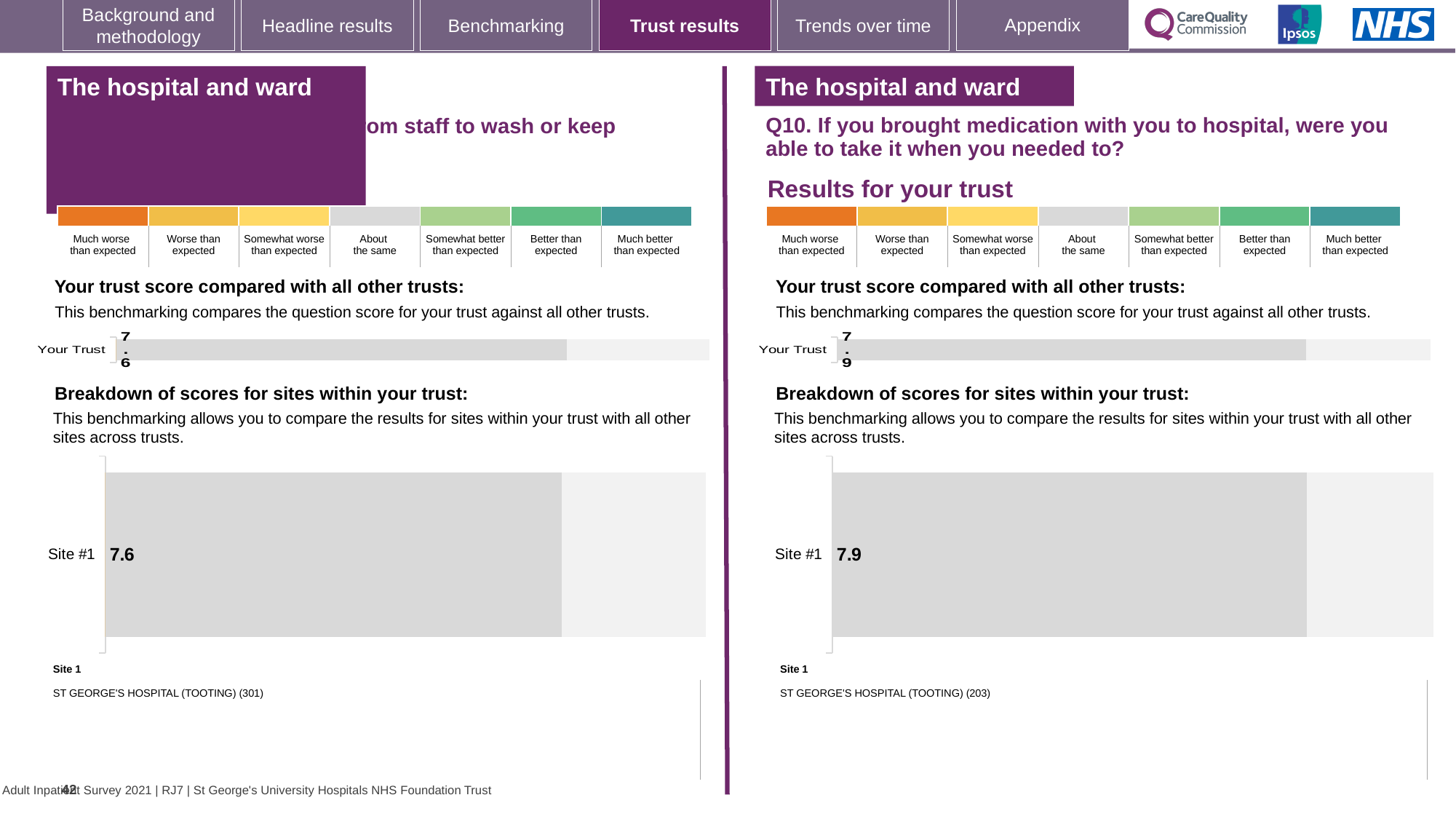
In the left-hand breakdown chart, which site name is listed as Site 1? ST GEORGE'S HOSPITAL (TOOTING) (301) In the right-hand breakdown chart (Q10), which site name is listed as Site 1? ST GEORGE'S HOSPITAL (TOOTING) (203) On the left-hand side of the slide, what is the score shown for Your Trust? 7.6 How many sites are shown in the right-hand 'Breakdown of scores for sites within your trust' chart (Q10)? 1 What kind of chart is used for the 'Breakdown of scores for sites within your trust' on the right-hand side (Q10)? Bar chart What is the difference between the Site #1 score in the right-hand breakdown chart (Q10) and the Site #1 score in the left-hand breakdown chart? 0.3 How many sites are shown in the left-hand 'Breakdown of scores for sites within your trust' chart? 1 In the left-hand 'Breakdown of scores for sites within your trust' chart, what is the score for Site #1? 7.6 Is the Your Trust score on the right-hand side of the slide (Q10) greater or less than the Your Trust score on the left-hand side? greater On the right-hand side of the slide (Q10, medication), what is the score shown for Your Trust? 7.9 In the right-hand 'Breakdown of scores for sites within your trust' chart (Q10), what is the score for Site #1? 7.9 Which is larger: the Site #1 score in the left-hand breakdown chart or the Site #1 score in the right-hand breakdown chart (Q10)? The right-hand chart (Q10)